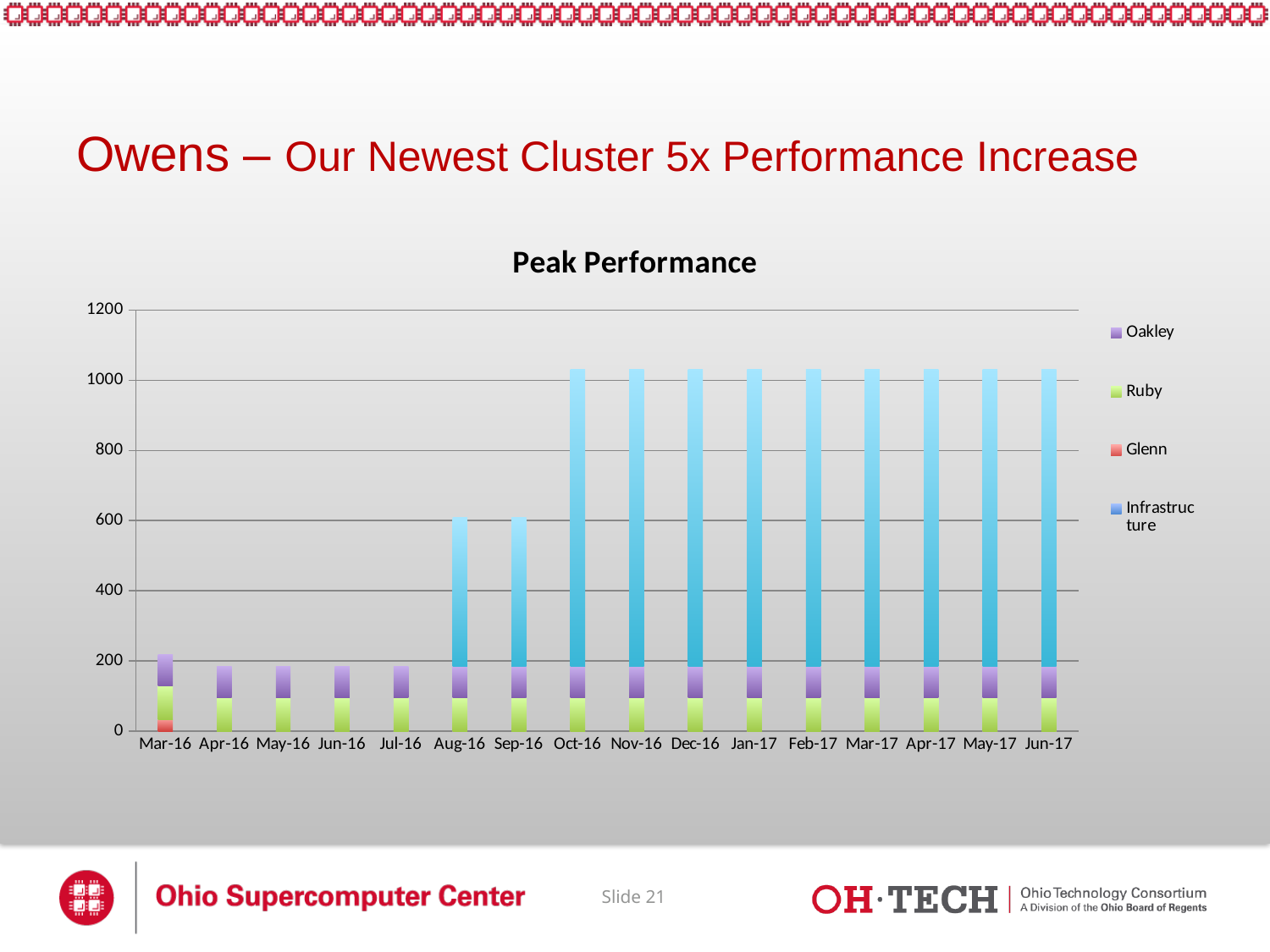
Is the total value for Sep-16 greater or less than 800? less Is the total value for Oct-16 greater or less than 800? greater Is the total value for Aug-16 greater or less than 400? greater Which month has the larger total, Aug-16 or Oct-16? Oct-16 What type of chart is shown on the slide? Stacked bar chart What is the title of the chart? Peak Performance Which is the only month in which the Glenn series appears? Mar-16 How many series does the legend list? 4 How many months are shown along the x axis? 16 Do the total values generally rise or fall from Mar-16 to Jun-17? Rise